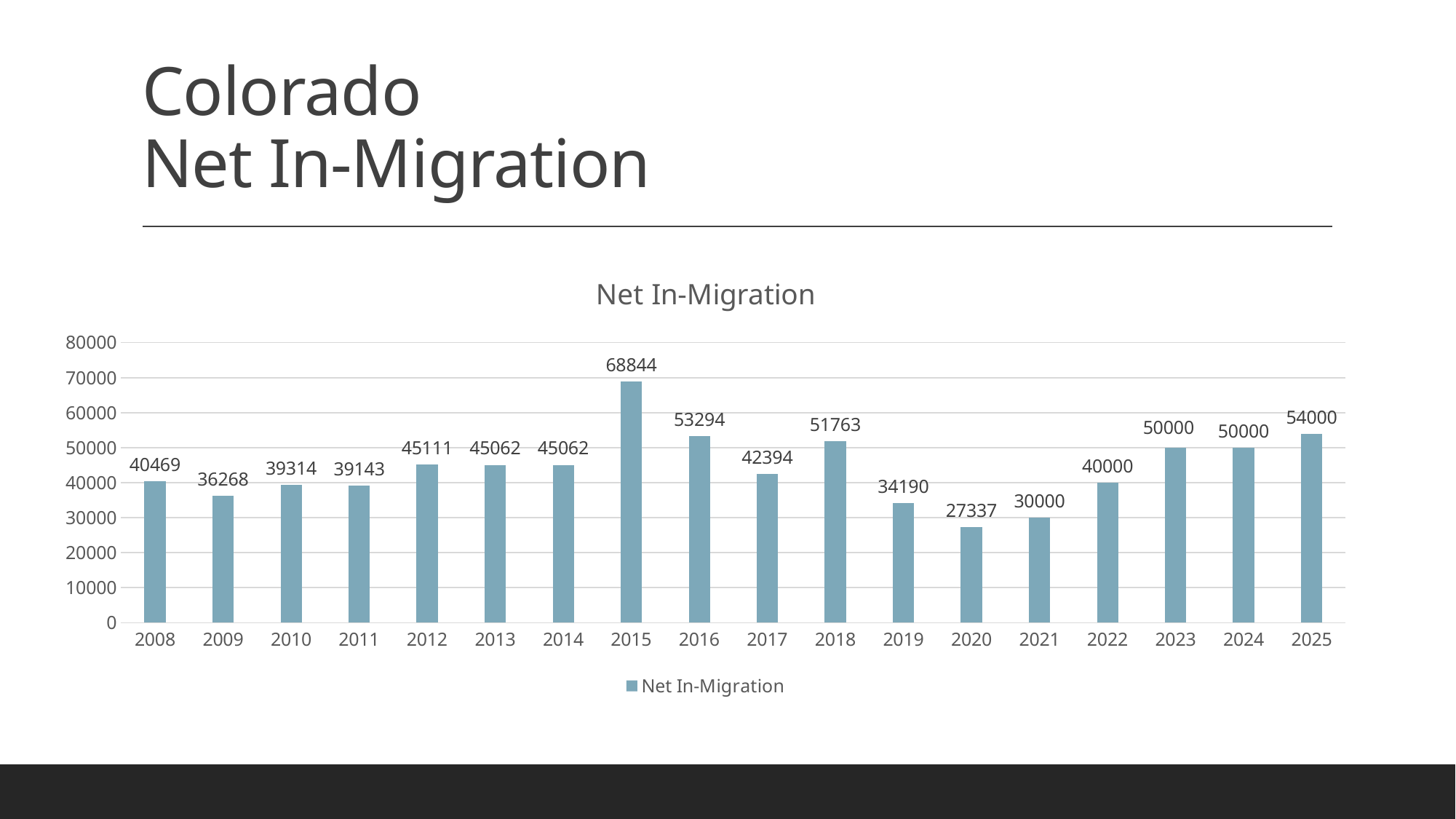
What is the net in-migration value for 2015? 68844 Which year has the highest net in-migration? 2015 Which year has a larger net in-migration, 2016 or 2018? 2016 How many years are shown on the x axis of the chart? 18 What is the net in-migration value for 2020? 27337 What is the title of the chart? Net In-Migration What is the net in-migration value for 2018? 51763 What is the difference between the net in-migration values for 2025 and 2024? 4000 What kind of chart is shown on the slide? bar chart What is the difference between the net in-migration values for 2015 and 2016? 15550 Is the value for 2019 greater or less than 40000? less Which year has the lowest net in-migration? 2020